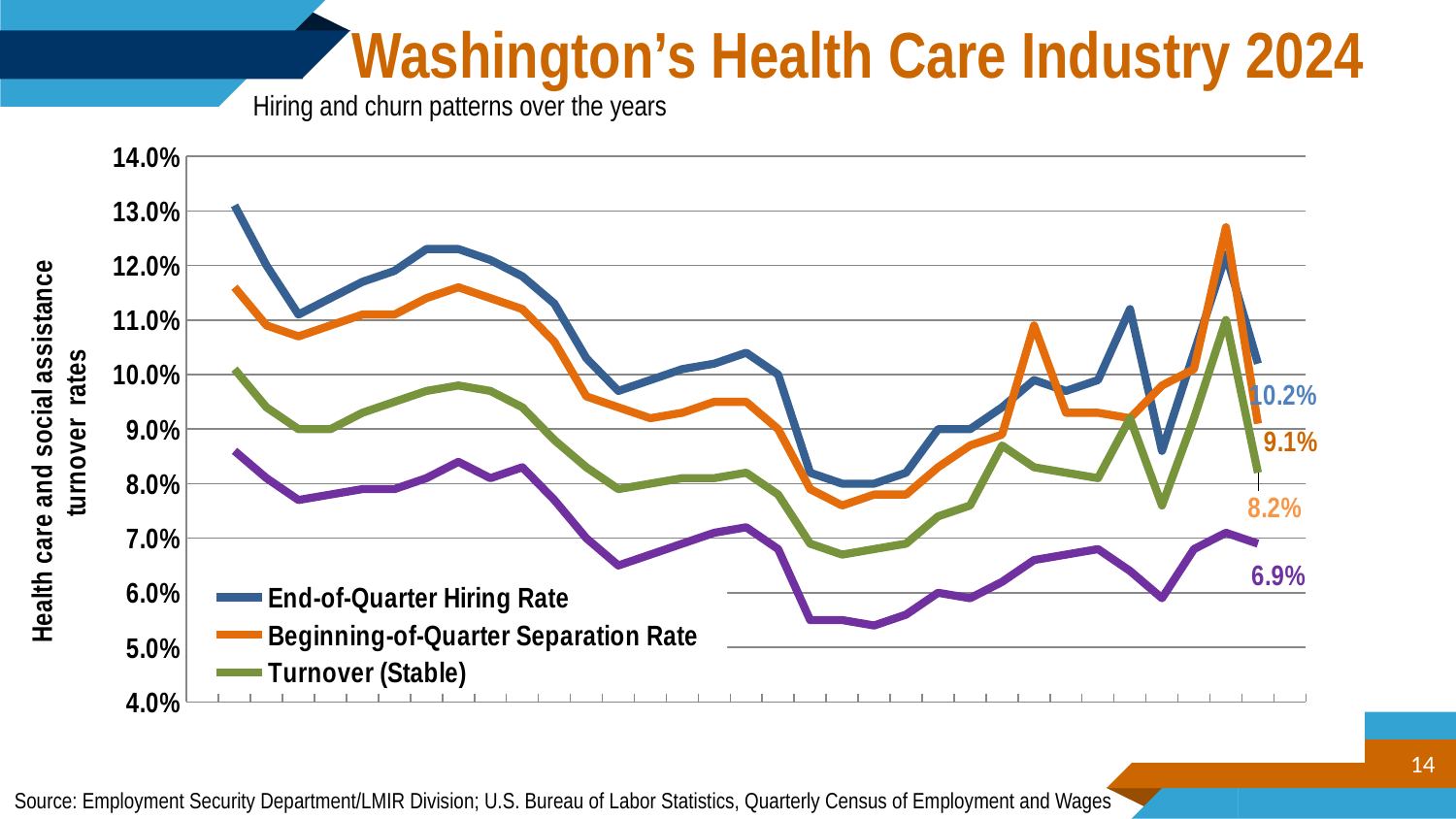
What is the final labelled value of the Turnover (Stable) line? 8.2% What is the difference between the final labelled values of the End-of-Quarter Hiring Rate (10.2%) and the Beginning-of-Quarter Separation Rate (9.1%)? 1.1% Is the first point of the End-of-Quarter Hiring Rate line greater or less than 12.0%? greater What kind of chart is shown on the slide? line chart Which line has the highest labelled value at the right end of the chart? End-of-Quarter Hiring Rate At the right end of the chart, which is larger: the End-of-Quarter Hiring Rate or the Turnover (Stable) rate? End-of-Quarter Hiring Rate What is the final labelled value of the Beginning-of-Quarter Separation Rate line? 9.1% Is the lowest point of the purple line greater or less than 6.0%? less What is the final labelled value of the purple line at the right end of the chart? 6.9% What is the title of the vertical axis? Health care and social assistance turnover rates What is the final labelled value of the End-of-Quarter Hiring Rate line? 10.2% How many series does the chart's legend list? 3